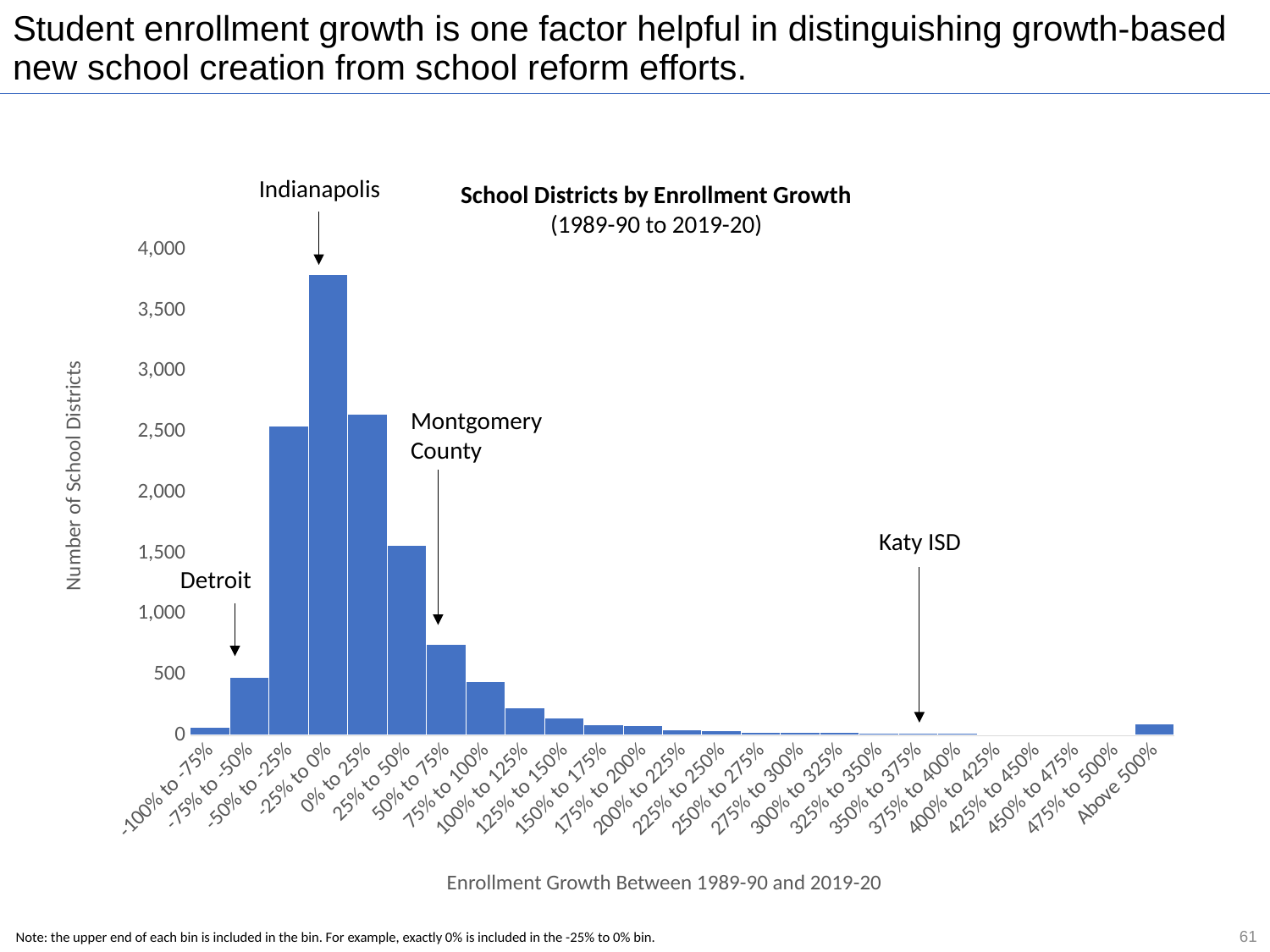
How many enrollment growth bins are shown on the x axis? 25 Is the number of school districts in the 50% to 75% bin greater or less than 1,000? less Which enrollment growth bin does the Katy ISD arrow point to? 350% to 375% Which bin has more school districts, 25% to 50% or 50% to 75%? 25% to 50% Is the number of school districts in the -25% to 0% bin greater or less than 3,500? greater Do the number of school districts rise or fall across the bins from 0% to 25% through 475% to 500%? fall Is the number of school districts in the -50% to -25% bin greater or less than 2,000? greater Which bin has more school districts, -100% to -75% or 75% to 100%? 75% to 100% Which enrollment growth bin has the highest number of school districts? -25% to 0% What kind of chart is shown on the slide? bar chart